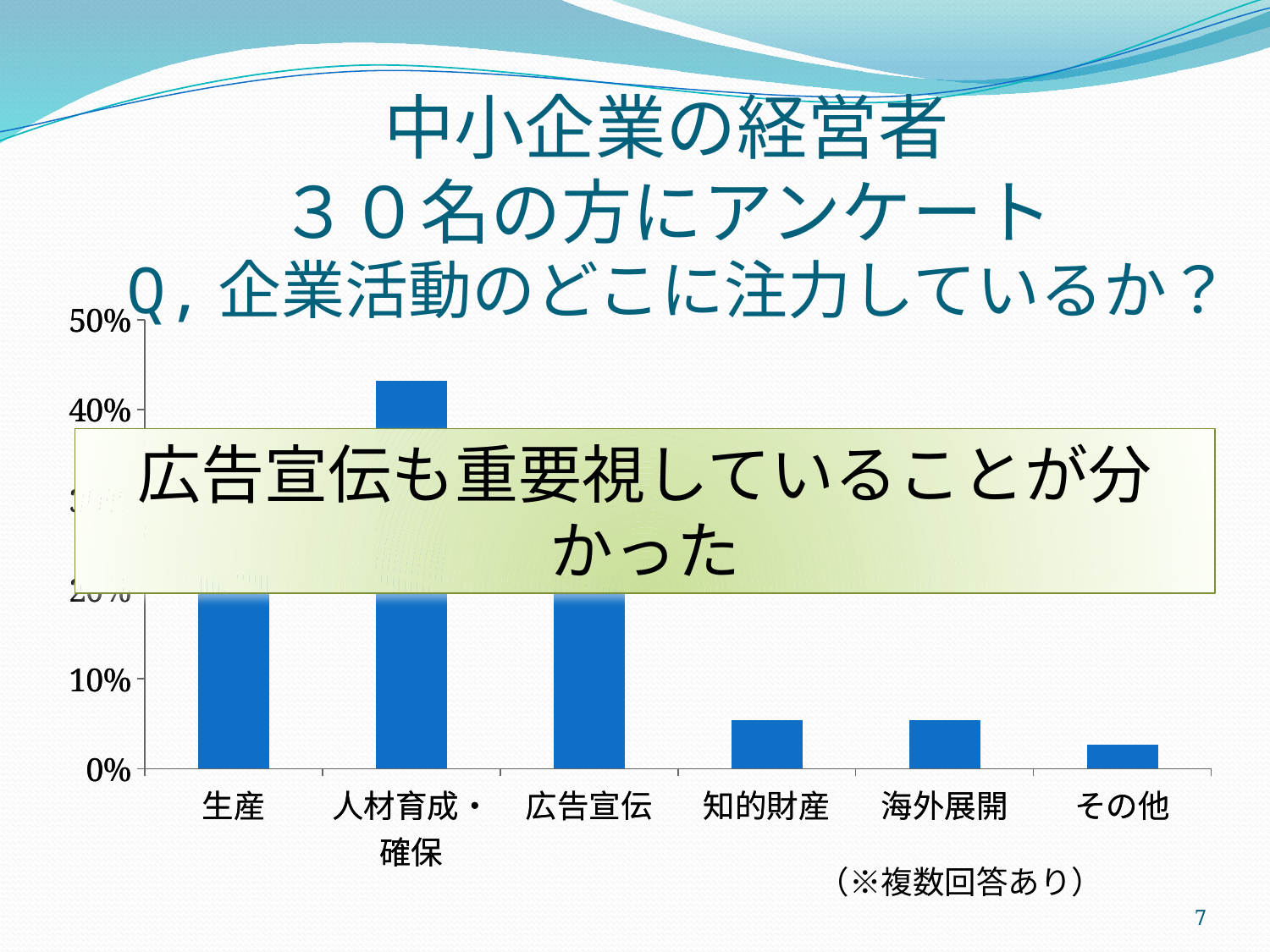
Which is larger, the value for 知的財産 or the value for その他? 知的財産 Is the value for 人材育成・確保 greater or less than 40%? greater Is the value for その他 greater or less than 10%? less What kind of chart is shown on the slide? bar chart Which category has the highest bar in the chart? 人材育成・確保 What colour are the bars in the chart? blue How many categories are shown on the x axis of the chart? 6 Which is larger, the value for 人材育成・確保 or the value for 知的財産? 人材育成・確保 Is the value for 知的財産 greater or less than 10%? less Which category has the lowest bar in the chart? その他